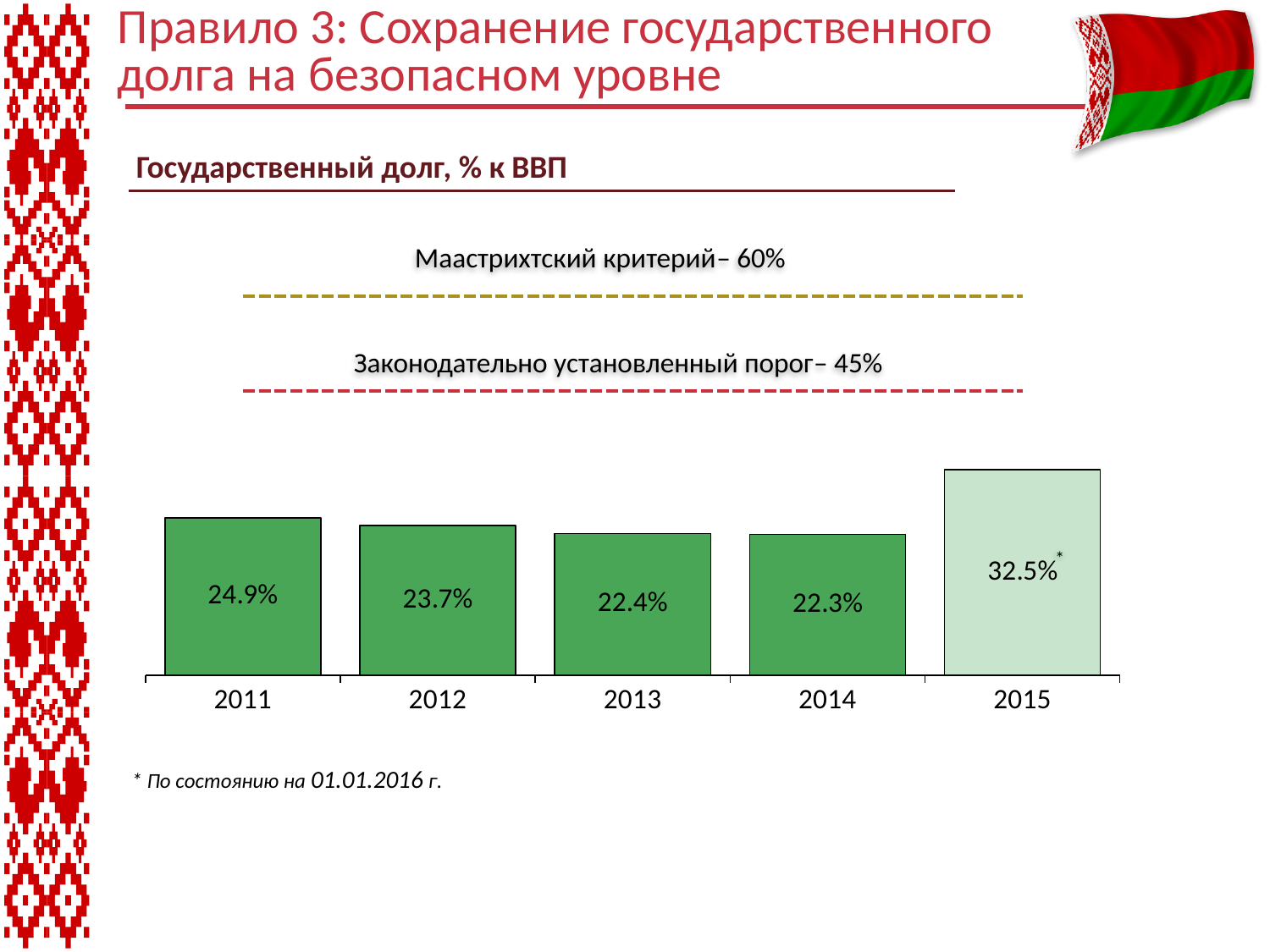
What is the government debt as % of GDP for 2015? 32.5% What kind of chart is shown on the slide? bar chart What is the government debt as % of GDP for 2011? 24.9% What is the difference between the 2011 and 2012 values? 1.2 percentage points Do the values rise or fall from 2011 to 2014? fall Is the value for 2015 greater or less than the legislatively established threshold of 45%? less Which is larger, the value for 2011 or the value for 2012? 2011 What is the value shown for 2013? 22.4% By how many percentage points did government debt as % of GDP rise from 2014 to 2015? 10.2 percentage points Which year has the lowest government debt as % of GDP? 2014 How many years are shown on the chart? 5 Which year has the highest government debt as % of GDP? 2015